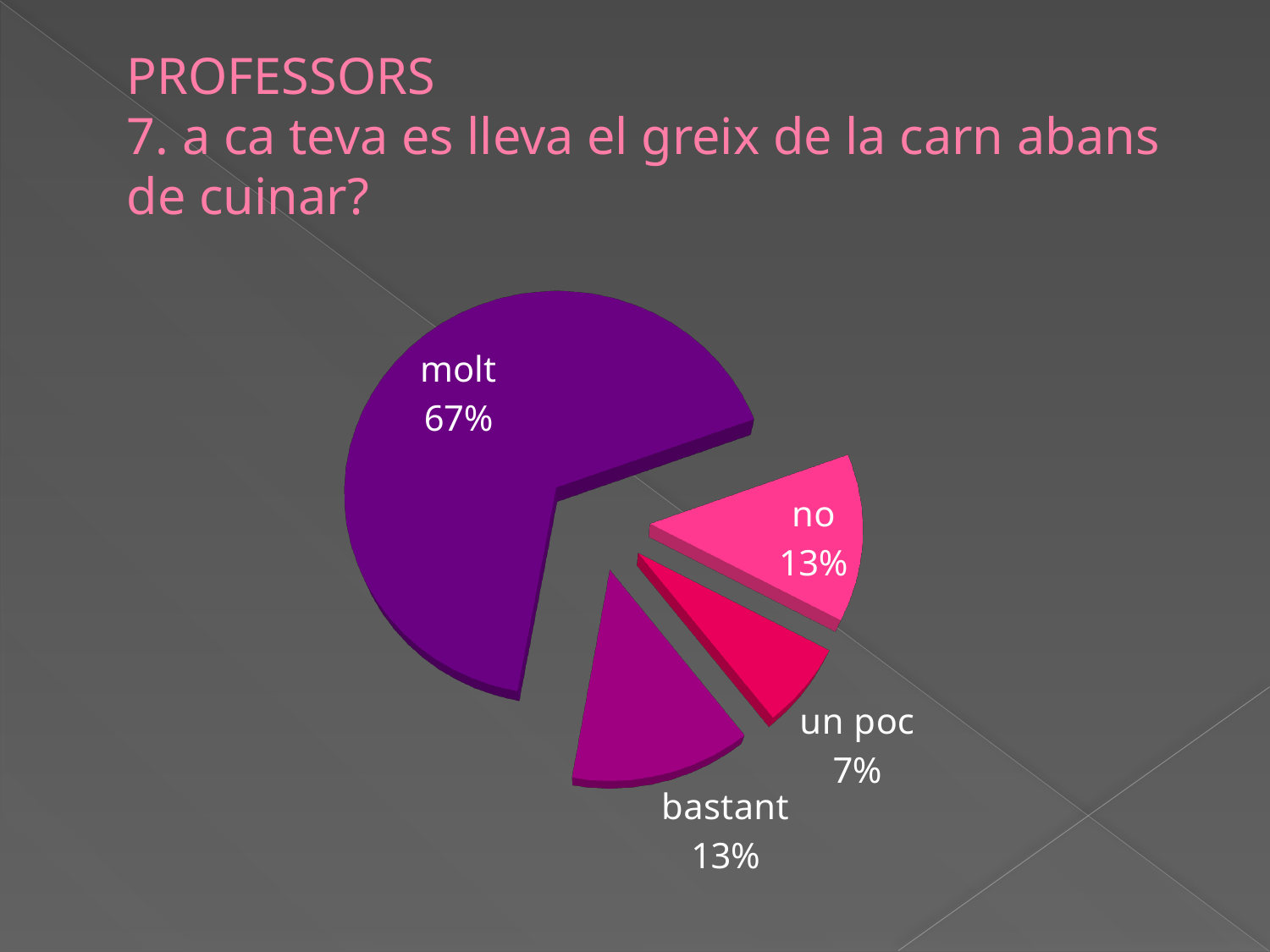
How many slices does the pie chart have? 4 Which category has the largest slice of the pie? molt Which category has the smallest slice of the pie? un poc What kind of chart is shown on the slide? pie chart What is the value shown for the "no" slice? 13% What is the difference in percentage points between the "bastant" slice and the "un poc" slice? 6 What is the value shown for the "un poc" slice? 7% Which is larger, the "bastant" slice or the "un poc" slice? bastant What question does the slide title say the chart is about? 7. a ca teva es lleva el greix de la carn abans de cuinar? What share of the pie does the "molt" slice represent? 67% What is the value shown for the "bastant" slice? 13% What is the difference in percentage points between the "molt" slice and the "no" slice? 54